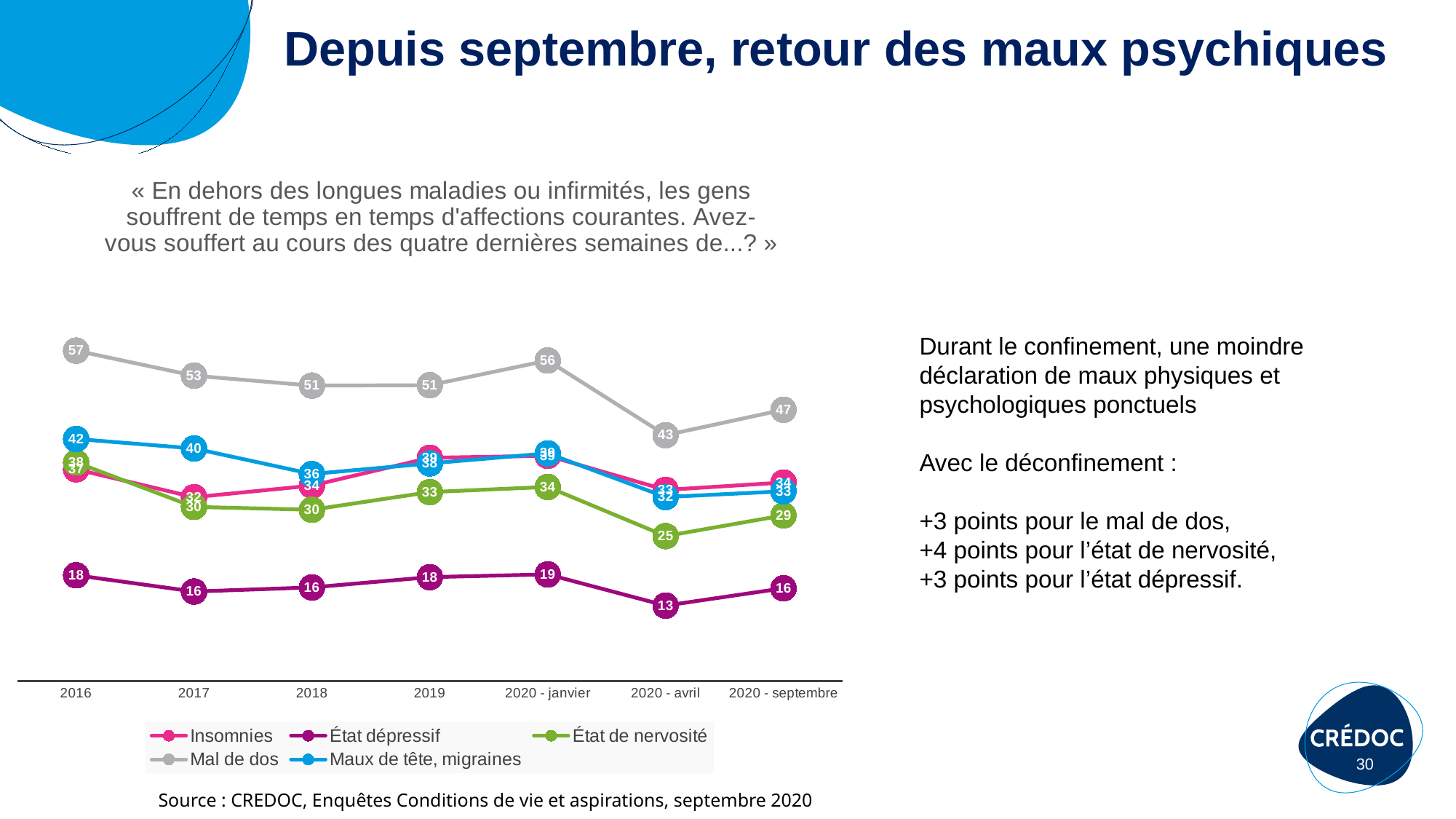
What is the difference between Mal de dos in 2020 - septembre and 2020 - avril? 4 What kind of chart is shown on the slide? line chart What is the value for État de nervosité in 2020 - septembre? 29 Does Mal de dos rise or fall from 2016 to 2018? fall In which period is Mal de dos at its highest? 2016 In which period is État dépressif at its lowest? 2020 - avril Which series is drawn in grey? Mal de dos How many time points are shown on the x axis? 7 In 2017, which is higher: Maux de tête, migraines or État de nervosité? Maux de tête, migraines How many series does the legend list? 5 What is the value for État dépressif in 2020 - avril? 13 What is the value for Mal de dos in 2016? 57